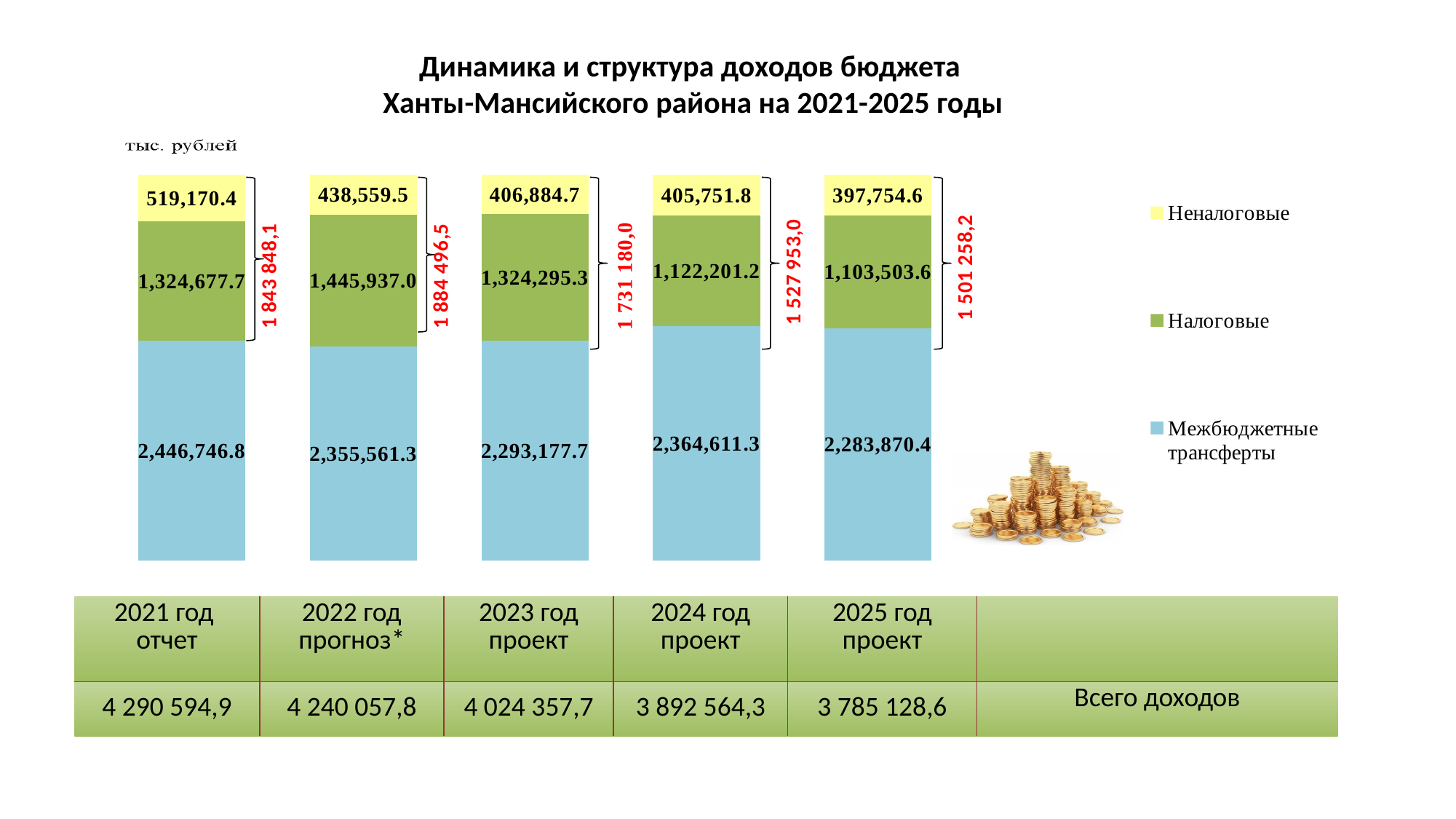
Which year has the larger Межбюджетные трансферты value, 2023 or 2024? 2024 год проект What is the total of the stacked bar for 2023 год проект (Всего доходов)? 4 024 357,7 How many series does the legend list? 3 What is the value of Неналоговые for 2025 год проект? 397,754.6 How many years (bars) are shown in the chart? 5 What is the value of Налоговые for 2022 год прогноз*? 1,445,937.0 In which year is the Неналоговые value the lowest? 2025 год проект What kind of chart is shown on the slide? Stacked bar chart Do the Неналоговые values rise or fall from 2021 to 2025? Fall What is the value of Межбюджетные трансферты for 2021 год отчет? 2,446,746.8 What is the difference between the Неналоговые values for 2021 and 2022? 80,610.9 In which year is the Налоговые value the highest? 2022 год прогноз*